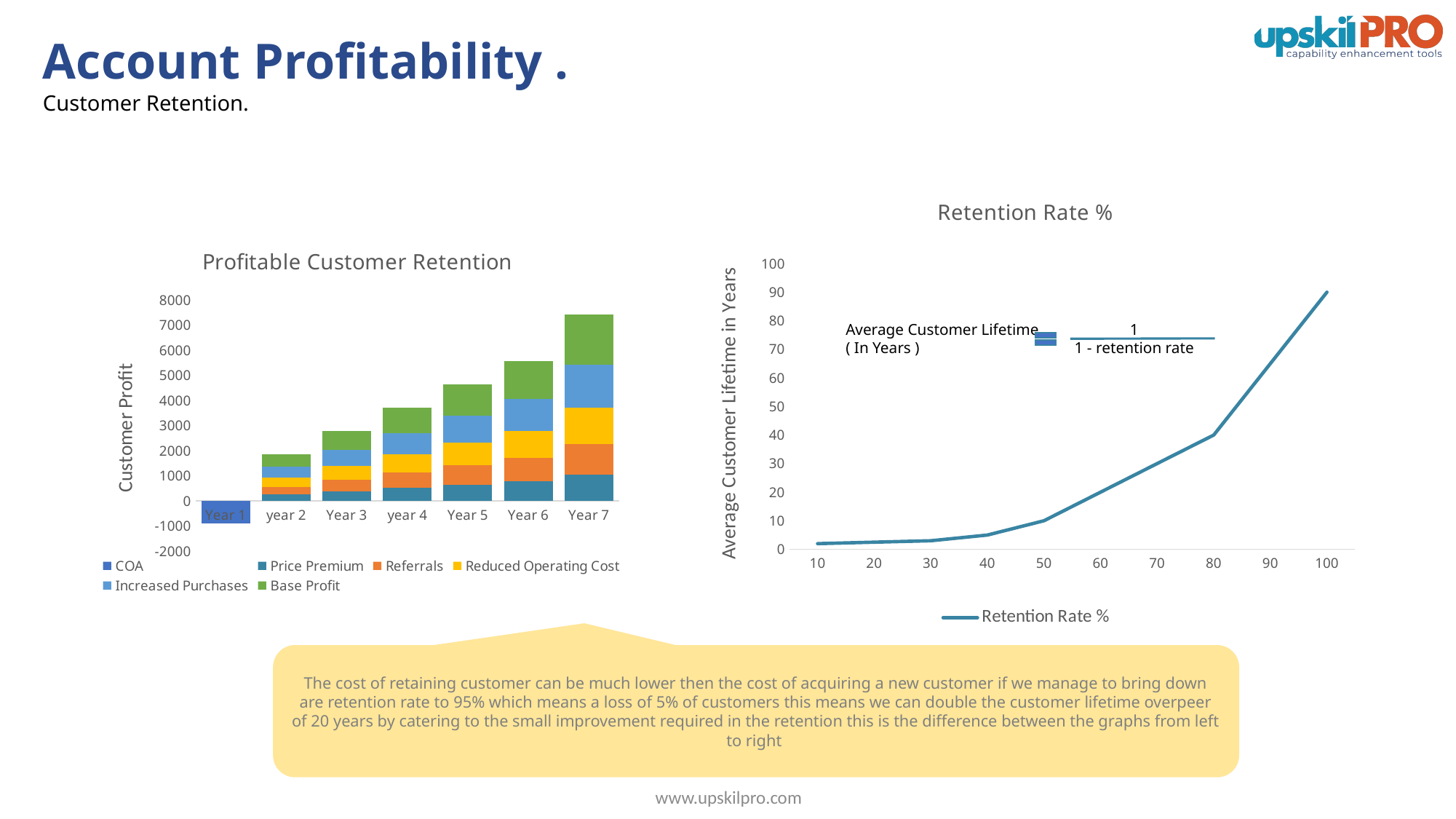
In the 'Retention Rate %' chart, is the value at a retention rate of 100 greater or less than 80? greater In the 'Profitable Customer Retention' chart, which year has the lowest customer profit? Year 1 What kind of chart is the 'Profitable Customer Retention' chart on the left? bar chart In the 'Profitable Customer Retention' chart, how many series does the legend list? 6 In the 'Profitable Customer Retention' chart, do the stacked bar totals rise or fall from Year 2 to Year 7? rise In the 'Profitable Customer Retention' chart, how many year categories are shown on the x axis? 7 In the 'Retention Rate %' chart, how many series does the legend list? 1 In the 'Retention Rate %' chart, is the value at a retention rate of 50 greater or less than 20? less In the 'Profitable Customer Retention' chart, is the total stacked value for Year 5 greater or less than 4000? greater In the 'Profitable Customer Retention' chart, which year has the tallest stacked bar? Year 7 What kind of chart is the 'Retention Rate %' chart on the right? line chart